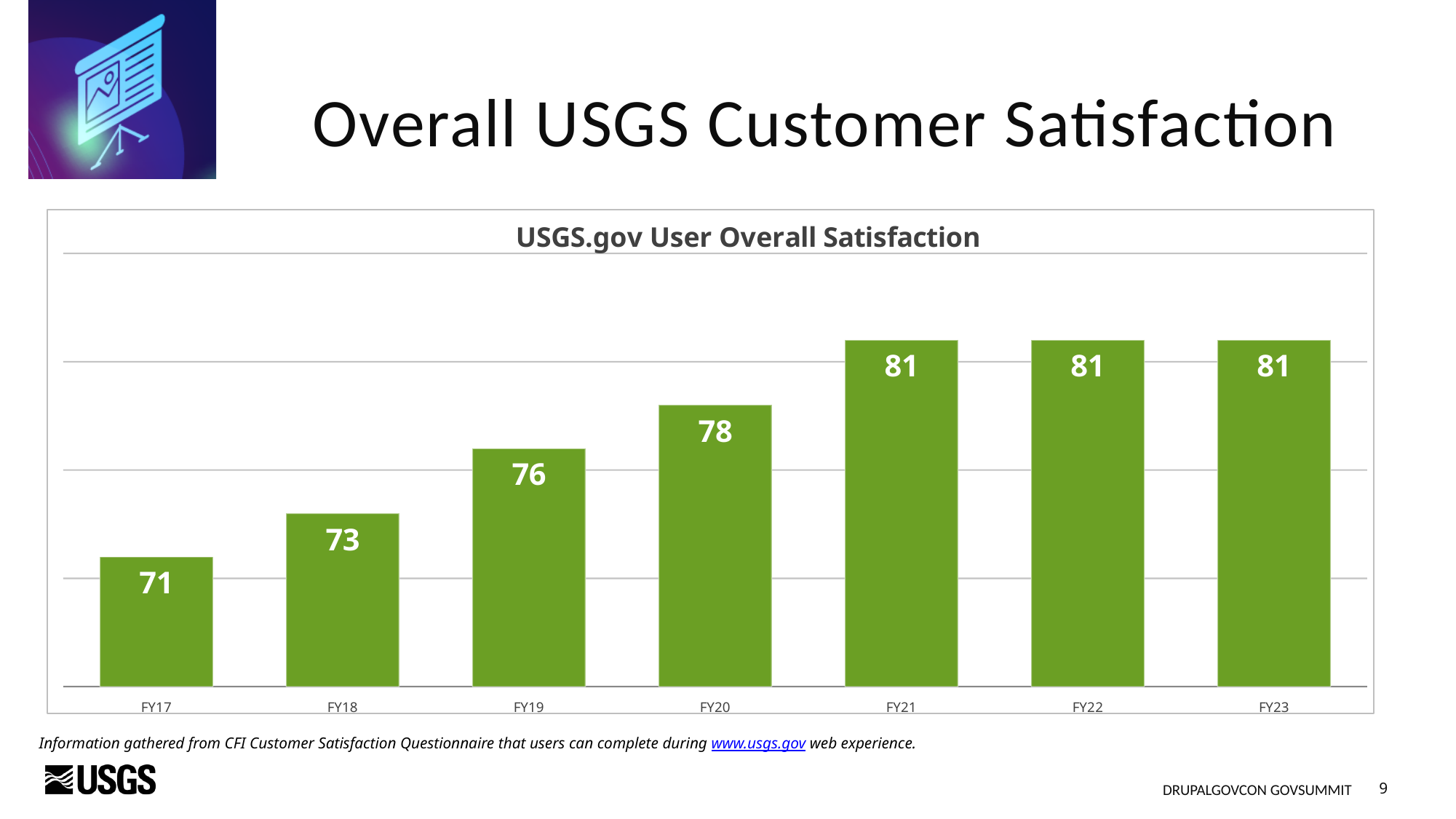
What is the difference between the FY23 and FY17 satisfaction values? 10 Which is larger, the value for FY18 or the value for FY20? FY20 Which fiscal year has the lowest satisfaction value? FY17 What is the satisfaction value for FY23? 81 Do the satisfaction values rise or fall from FY17 to FY21? Rise What is the difference between the FY19 and FY18 satisfaction values? 3 What colour are the bars in the chart? Green What kind of chart is shown on the slide? Bar chart What is the title of the chart? USGS.gov User Overall Satisfaction How many fiscal years are shown on the chart? 7 What is the satisfaction value for FY17? 71 What is the satisfaction value for FY20? 78